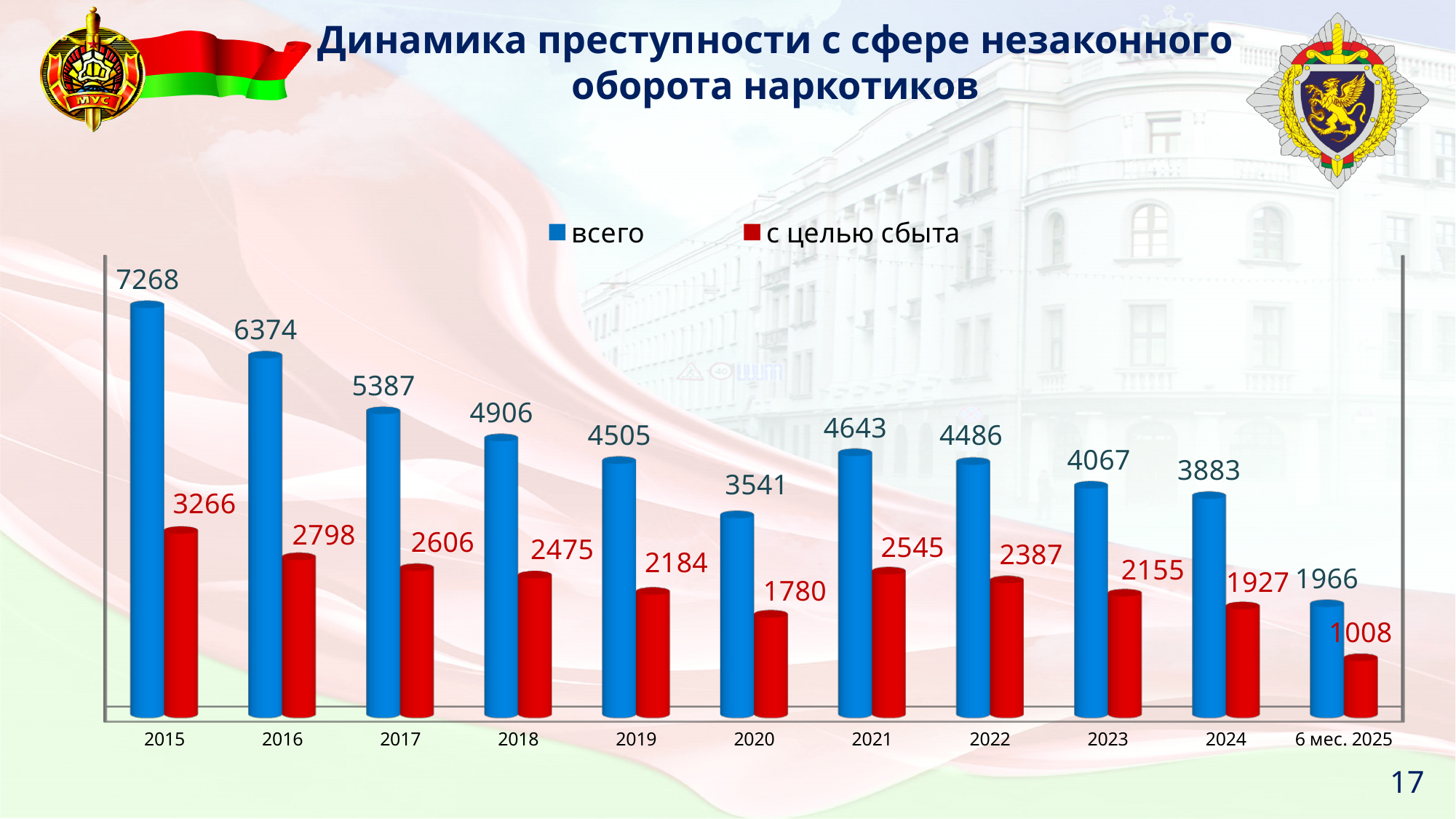
What is the difference between "всего" and "с целью сбыта" in 2021? 2098 What is the value of "всего" for 6 мес. 2025? 1966 How many series does the legend list? 2 Which is larger: "всего" in 2020 or "всего" in 2024? 2024 Do the values for "всего" generally rise or fall from 2015 to 2024? fall Which category has the lowest value for "с целью сбыта"? 6 мес. 2025 Which year has the highest value for "всего"? 2015 Which colour represents the series "с целью сбыта"? red What is the value of "всего" for 2015? 7268 What kind of chart is shown on the slide? bar chart How many categories are shown on the x axis? 11 What is the value of "с целью сбыта" for 2020? 1780